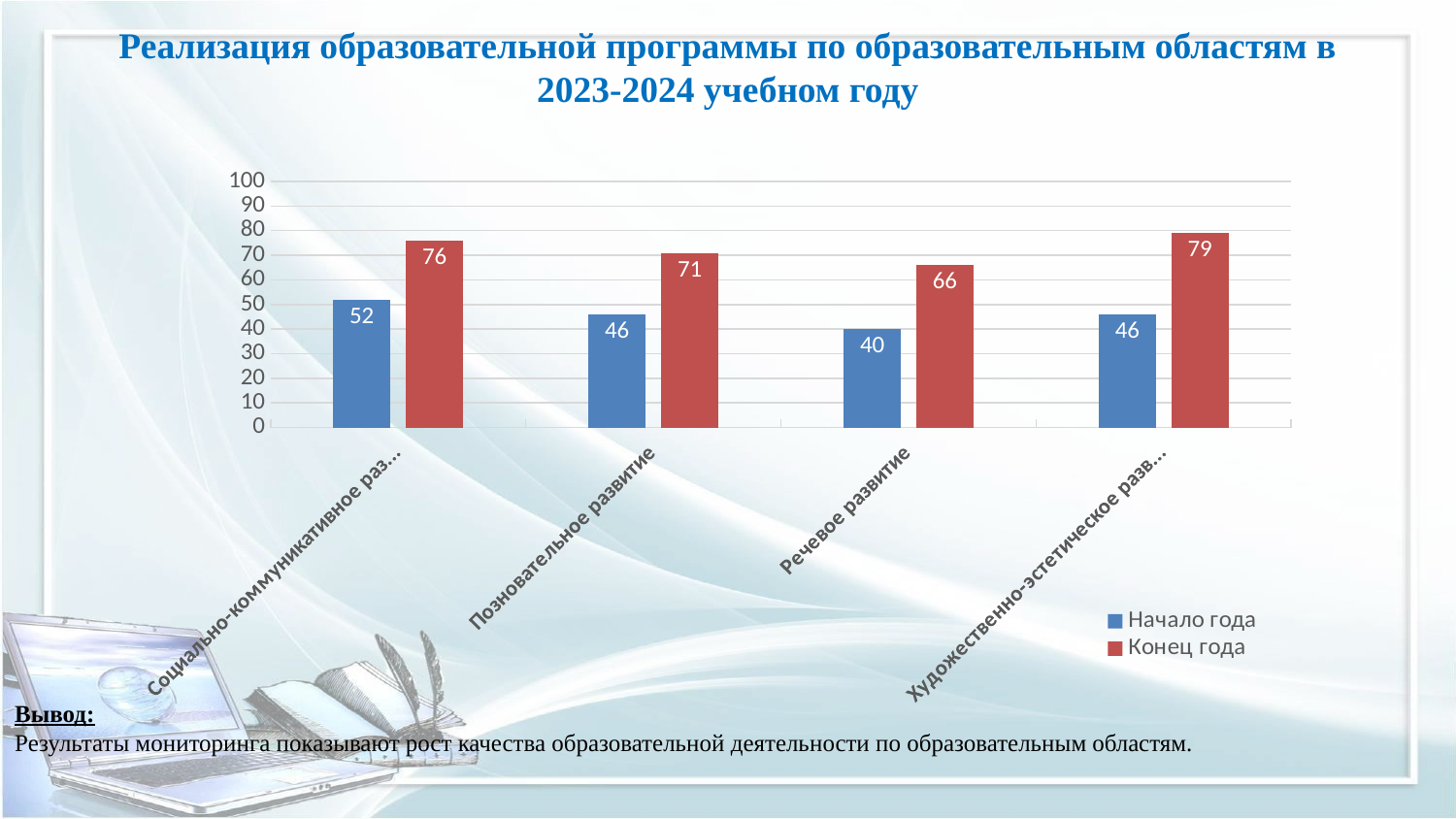
Which is larger for Познавательное развитие: the Начало года value or the Конец года value? Конец года What is the value for Познавательное развитие at the end of the year (Конец года)? 71 What is the value for Речевое развитие at the start of the year (Начало года)? 40 What is the difference between the Конец года values for Художественно-эстетическое развитие and Познавательное развитие? 8 What is the Конец года value for Речевое развитие? 66 Which category has the lowest Начало года value? Речевое развитие Which series is shown in red in the legend? Конец года What is the difference between the Конец года and Начало года values for Речевое развитие? 26 How many categories are shown on the x axis? 4 How many series does the legend list? 2 What type of chart is shown on the slide? bar chart Which category has the highest Конец года value? Художественно-эстетическое развитие